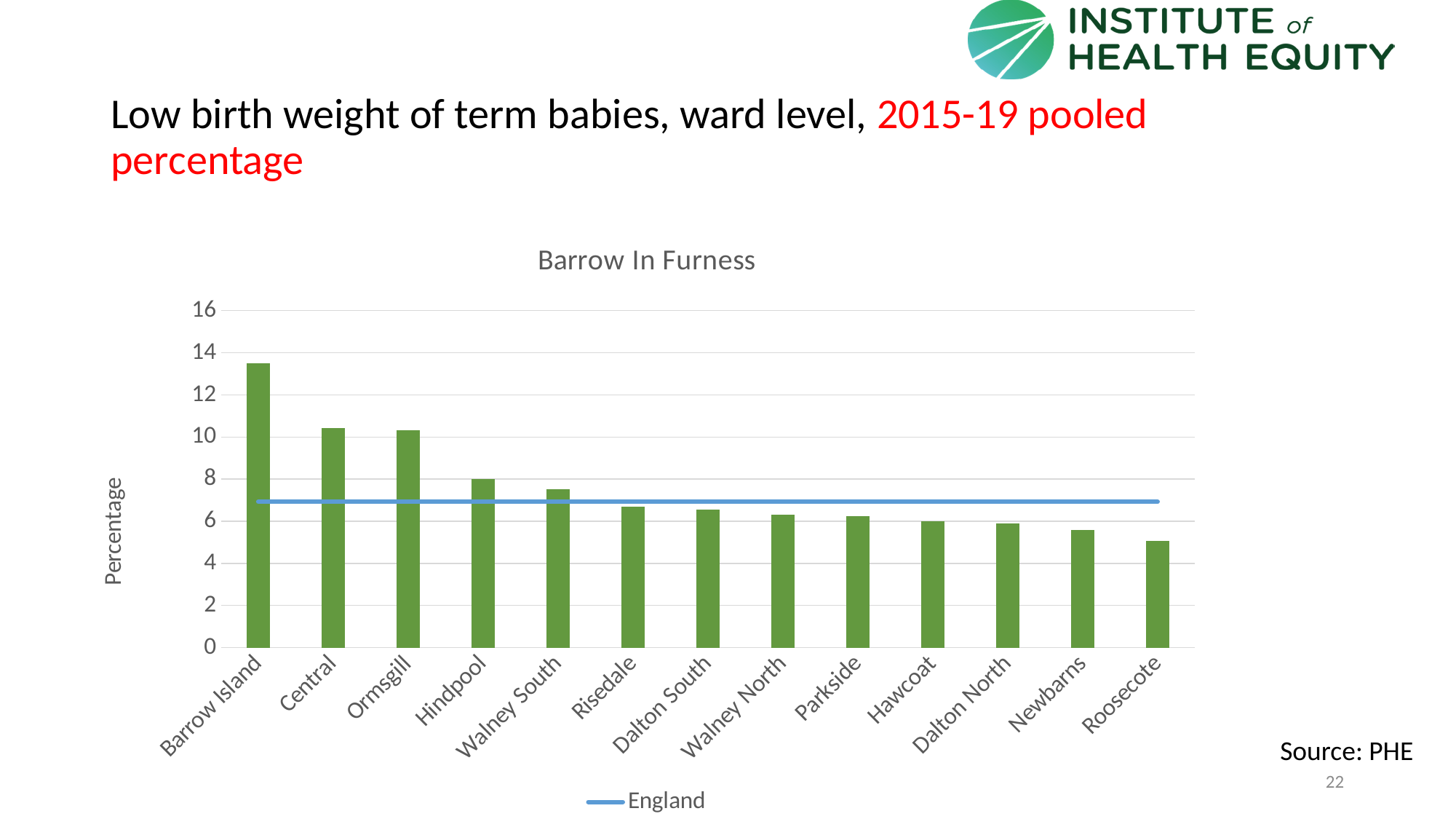
Is the value for Walney South greater or less than 8? less What kind of chart is shown on the slide? bar chart What is the title of the chart? Barrow In Furness Do the bar values rise or fall moving from left to right along the x axis? fall What is the label on the vertical axis of the chart? Percentage Is the value for Roosecote greater or less than 6? less Which ward has the highest low birth weight percentage? Barrow Island How many wards are shown on the x axis of the chart? 13 Is the value for Barrow Island greater or less than 12? greater Which ward has the lowest low birth weight percentage? Roosecote Which is larger, the value for Barrow Island or the value for Central? Barrow Island How many entries does the chart's legend list? 1